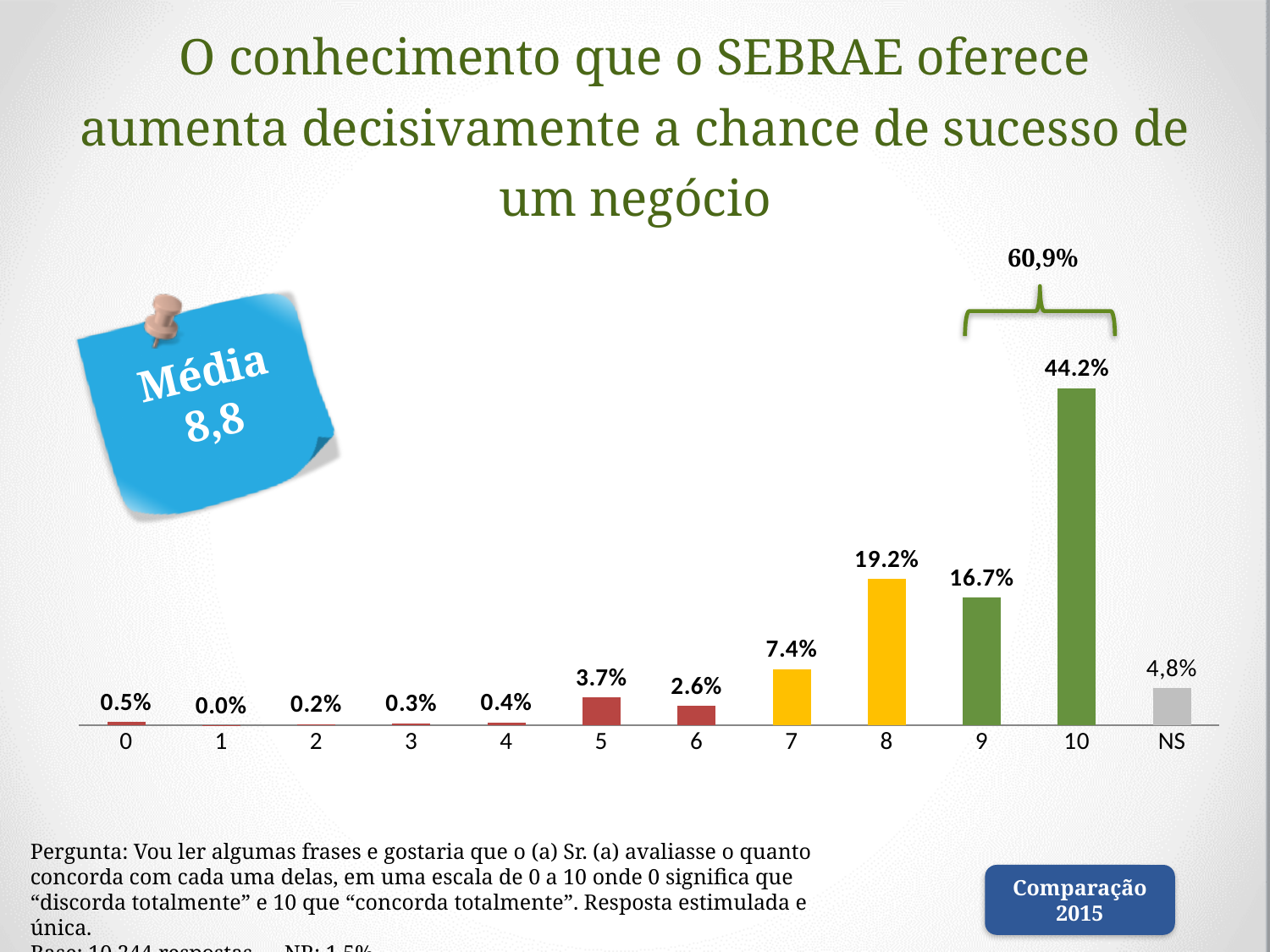
Which category has the highest value? 10 What is the value for the NS category? 4,8% Which is larger, the value for category 8 or the value for category 9? 8 What is the difference between the values for categories 10 and 9? 27.5% What is the value for category 10? 44.2% How many categories are shown on the x axis? 12 What is the value for category 5? 3.7% Which category has the lowest value? 1 What average (Média) is shown on the sticky note? 8,8 What is the value for category 8? 19.2% What kind of chart is shown on the slide? bar chart What combined percentage is shown by the bracket above categories 9 and 10? 60,9%